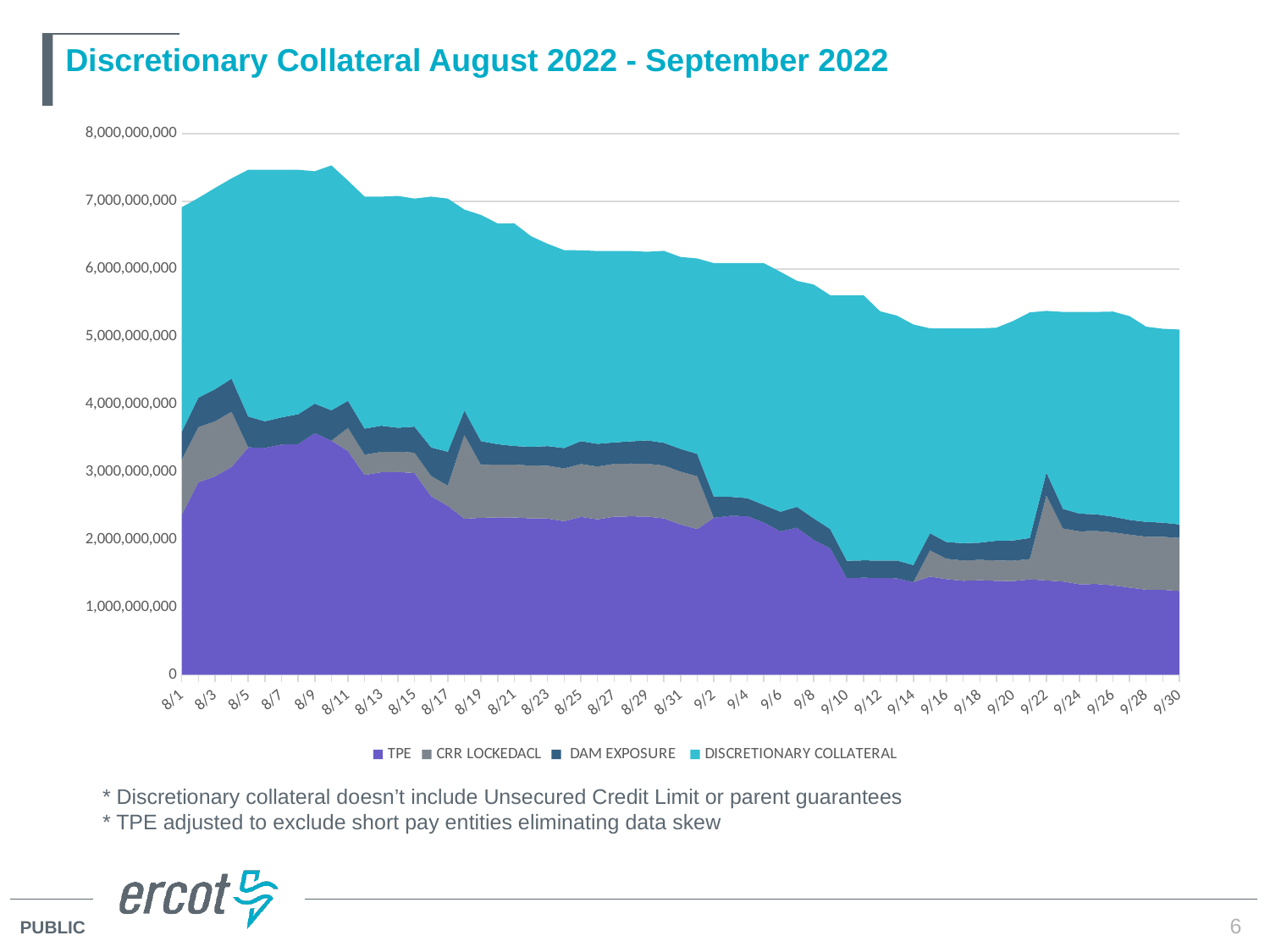
What kind of chart is shown on the slide? Stacked area chart Is the TPE value on 9/30 greater or less than 2,000,000,000? less Is the total stacked value larger on 8/1 or on 9/30? 8/1 Does the TPE series rise or fall overall from 8/9 to 9/30? Fall Does the total stacked value rise or fall overall from 8/1 to 9/30? Fall How many series does the legend list? 4 Is the TPE value on 8/9 greater or less than 3,000,000,000? greater Is the total stacked value on 8/9 greater or less than 7,000,000,000? greater Which series is plotted at the top of the stack? DISCRETIONARY COLLATERAL Is the TPE value larger on 8/9 or on 9/12? 8/9 What is the title of the chart? Discretionary Collateral August 2022 - September 2022